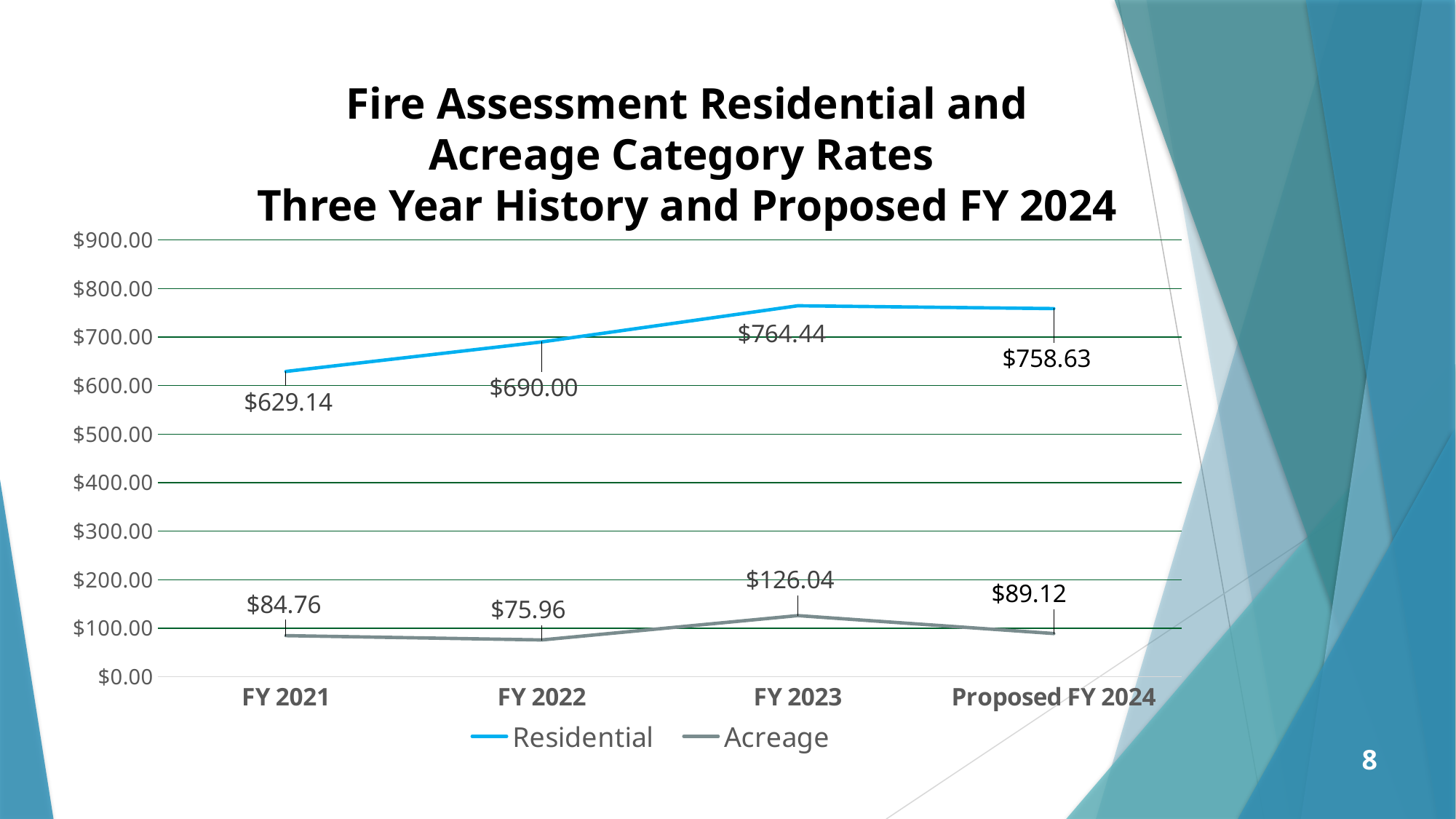
What is the Acreage rate for FY 2023? $126.04 What kind of chart is this? Line chart Does the Residential rate rise or fall from FY 2021 to FY 2023? Rise How many series does the legend list? 2 How many fiscal year categories are shown on the x axis? 4 In which year is the Residential rate highest? FY 2023 In which year is the Acreage rate lowest? FY 2022 What is the Acreage rate for FY 2021? $84.76 What is the difference between the Residential rate in FY 2023 and in FY 2021? $135.30 What is the Residential rate for Proposed FY 2024? $758.63 Which is larger, the Acreage rate for FY 2021 or for Proposed FY 2024? Proposed FY 2024 What is the Residential rate for FY 2022? $690.00